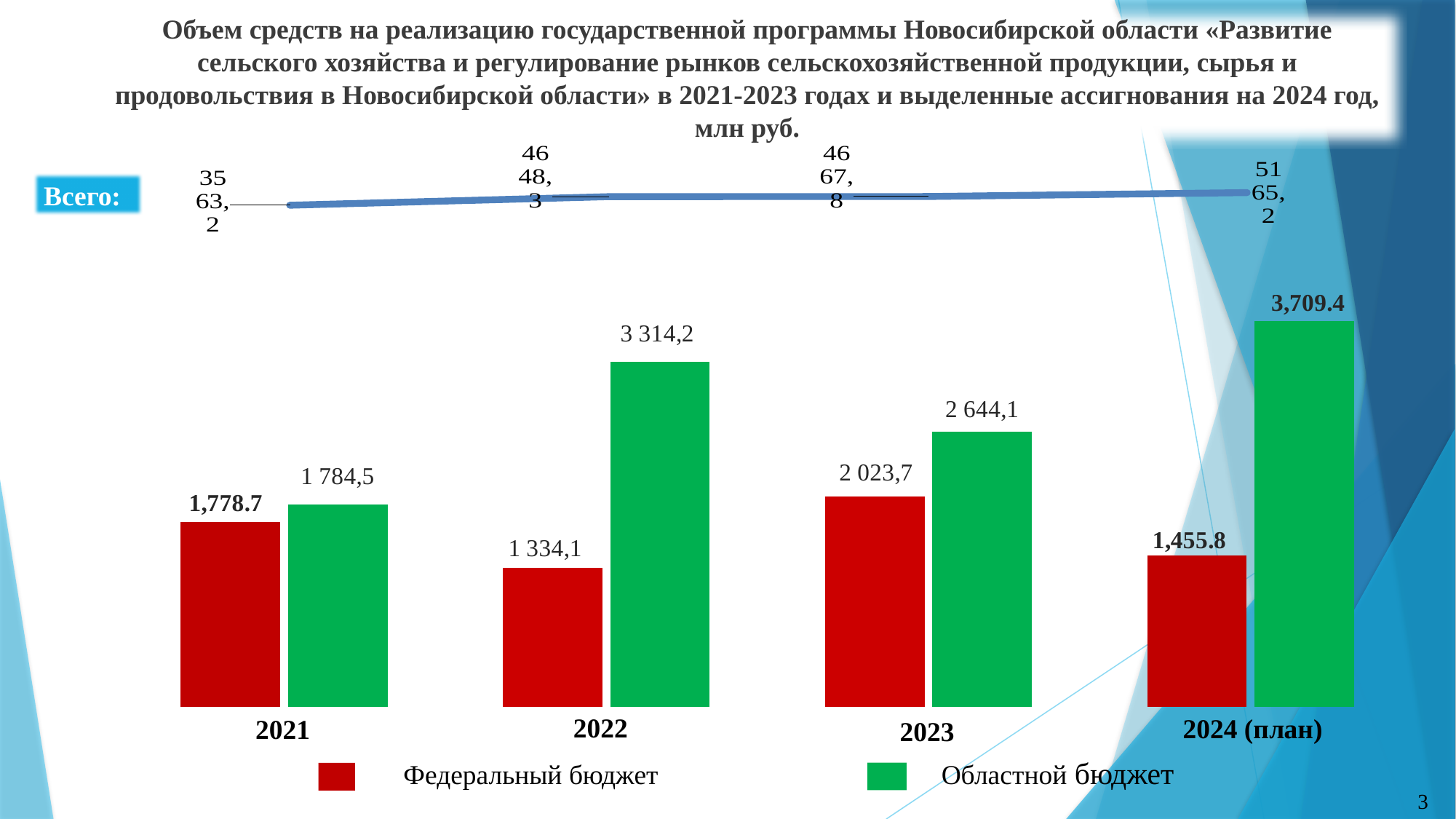
How many year categories are shown on the x axis? 4 What is the value for Областной бюджет in 2024 (план)? 3,709.4 What is the value for Федеральный бюджет in 2021? 1,778.7 Which colour represents Федеральный бюджет in the legend? red What type of chart is shown on the slide? bar chart What is the value for Федеральный бюджет in 2023? 2 023,7 What is the difference between Областной бюджет and Федеральный бюджет in 2022? 1 980,1 In which year is the Федеральный бюджет value lowest? 2022 Which is larger in 2023: Федеральный бюджет or Областной бюджет? Областной бюджет What is the value for Областной бюджет in 2022? 3 314,2 How many series does the legend list? 2 In which year is the Областной бюджет value highest? 2024 (план)